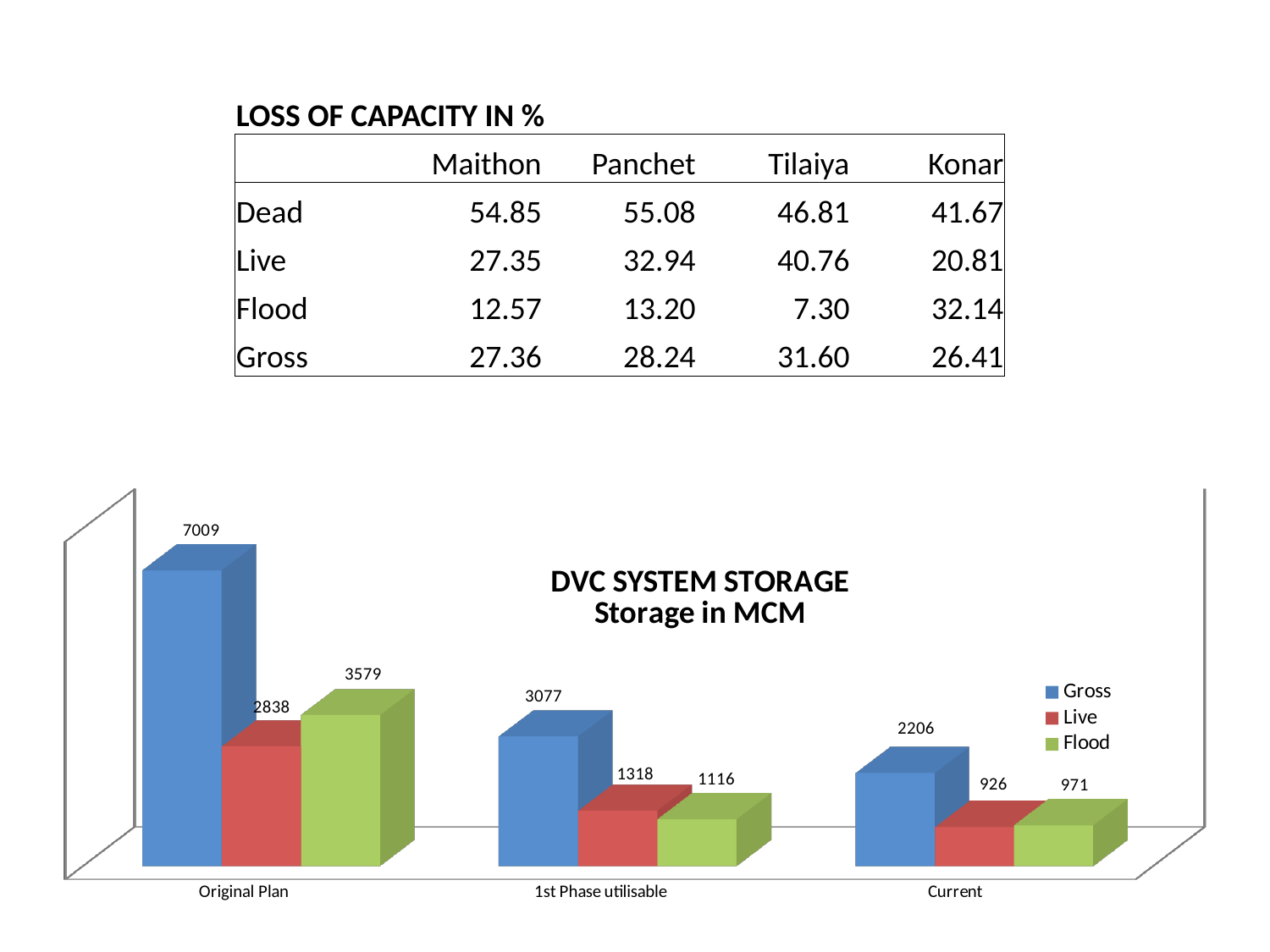
Which category has the highest Gross storage value? Original Plan What is the Gross storage value for Original Plan? 7009 Which category has the lowest Live storage value? Current What is the difference between the Flood value and the Live value for Original Plan? 741 What is the Flood storage value for Current? 971 For Current, which is larger: the Live value or the Flood value? Flood What kind of chart is shown on the slide? bar chart What is the Live storage value for 1st Phase utilisable? 1318 What is the difference between the Gross value for Original Plan and the Gross value for Current? 4803 How many series does the chart legend list? 3 Do the Gross values rise or fall from Original Plan to Current along the x axis? fall How many categories are shown on the x axis of the chart? 3